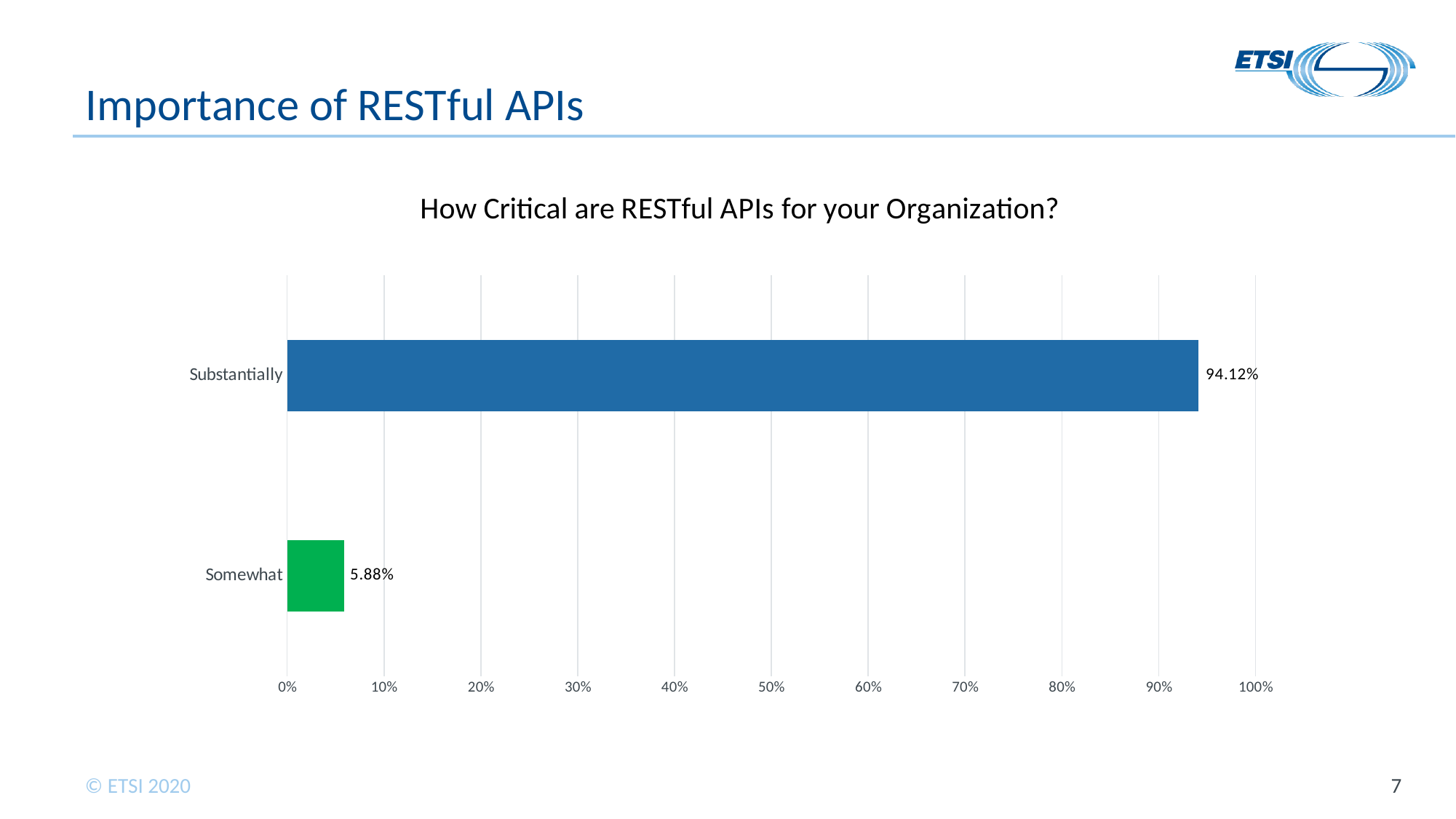
What kind of chart is shown on the slide? Bar chart What is the value for Substantially? 94.12% Which is larger, the value for Substantially or the value for Somewhat? Substantially Is the value for Substantially greater or less than 90%? greater Which category has the highest value? Substantially What is the title of the chart? How Critical are RESTful APIs for your Organization? What is the value for Somewhat? 5.88% Which category has the lowest value? Somewhat Is the value for Somewhat greater or less than 10%? less How many categories are shown in the chart? 2 What is the difference between the values for Substantially and Somewhat? 88.24% What colour is the bar for Somewhat? Green